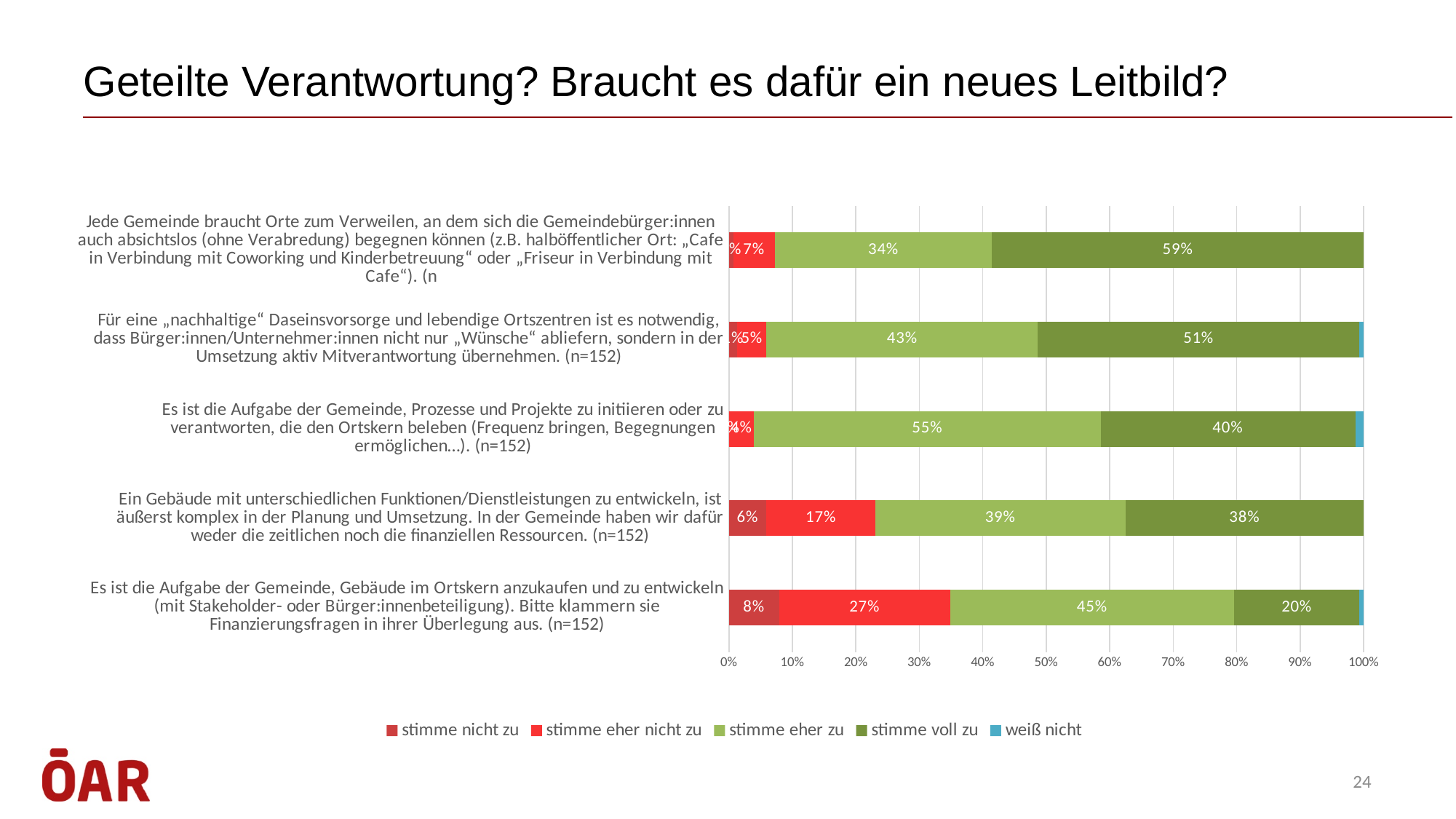
What percentage answered "stimme voll zu" to the statement "Jede Gemeinde braucht Orte zum Verweilen..."? 59% Which statement has a larger "stimme eher nicht zu" share: "Ein Gebäude mit unterschiedlichen Funktionen..." or "Es ist die Aufgabe der Gemeinde, Gebäude im Ortskern anzukaufen..."? Es ist die Aufgabe der Gemeinde, Gebäude im Ortskern anzukaufen... Which statement has the highest share of "stimme voll zu"? Jede Gemeinde braucht Orte zum Verweilen... How many series does the legend list? 5 What percentage answered "stimme nicht zu" to the statement "Ein Gebäude mit unterschiedlichen Funktionen/Dienstleistungen zu entwickeln..."? 6% What percentage answered "stimme eher zu" to the statement "Es ist die Aufgabe der Gemeinde, Prozesse und Projekte zu initiieren..."? 55% What colour represents "weiß nicht" in the legend? Blue Which statement has the lowest share of "stimme voll zu"? Es ist die Aufgabe der Gemeinde, Gebäude im Ortskern anzukaufen... For the statement "Ein Gebäude mit unterschiedlichen Funktionen...", what is the difference between the "stimme eher zu" and "stimme voll zu" shares? 1% What percentage answered "stimme eher nicht zu" to the statement "Es ist die Aufgabe der Gemeinde, Gebäude im Ortskern anzukaufen..."? 27% What kind of chart is shown on the slide? Stacked bar chart How many statements (bars) are shown in the chart? 5